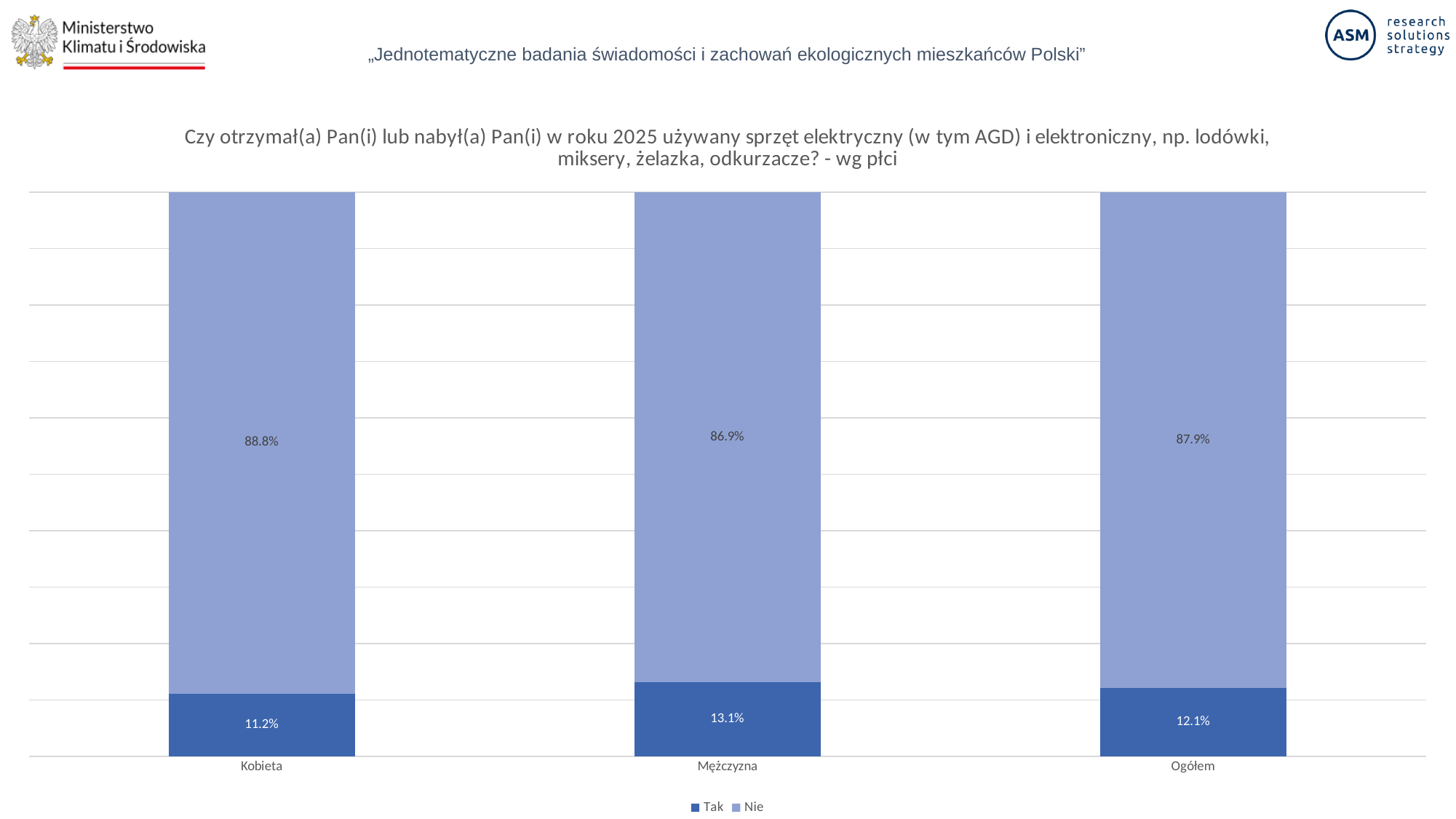
What is the difference between the 'Tak' values for Mężczyzna and Kobieta? 1.9% What is the 'Nie' value for Kobieta? 88.8% How many categories are shown on the x axis? 3 What is the 'Nie' value for Mężczyzna? 86.9% Which category has the lowest 'Nie' value? Mężczyzna Which category has the highest 'Tak' value? Mężczyzna What kind of chart is shown on the slide? Stacked bar chart What is the 'Tak' value for Kobieta? 11.2% How many series does the legend list? 2 What is the 'Tak' value for Ogółem? 12.1% What is the total of the stacked bar for Ogółem? 100% Which is larger: the 'Nie' value for Kobieta or for Ogółem? Kobieta